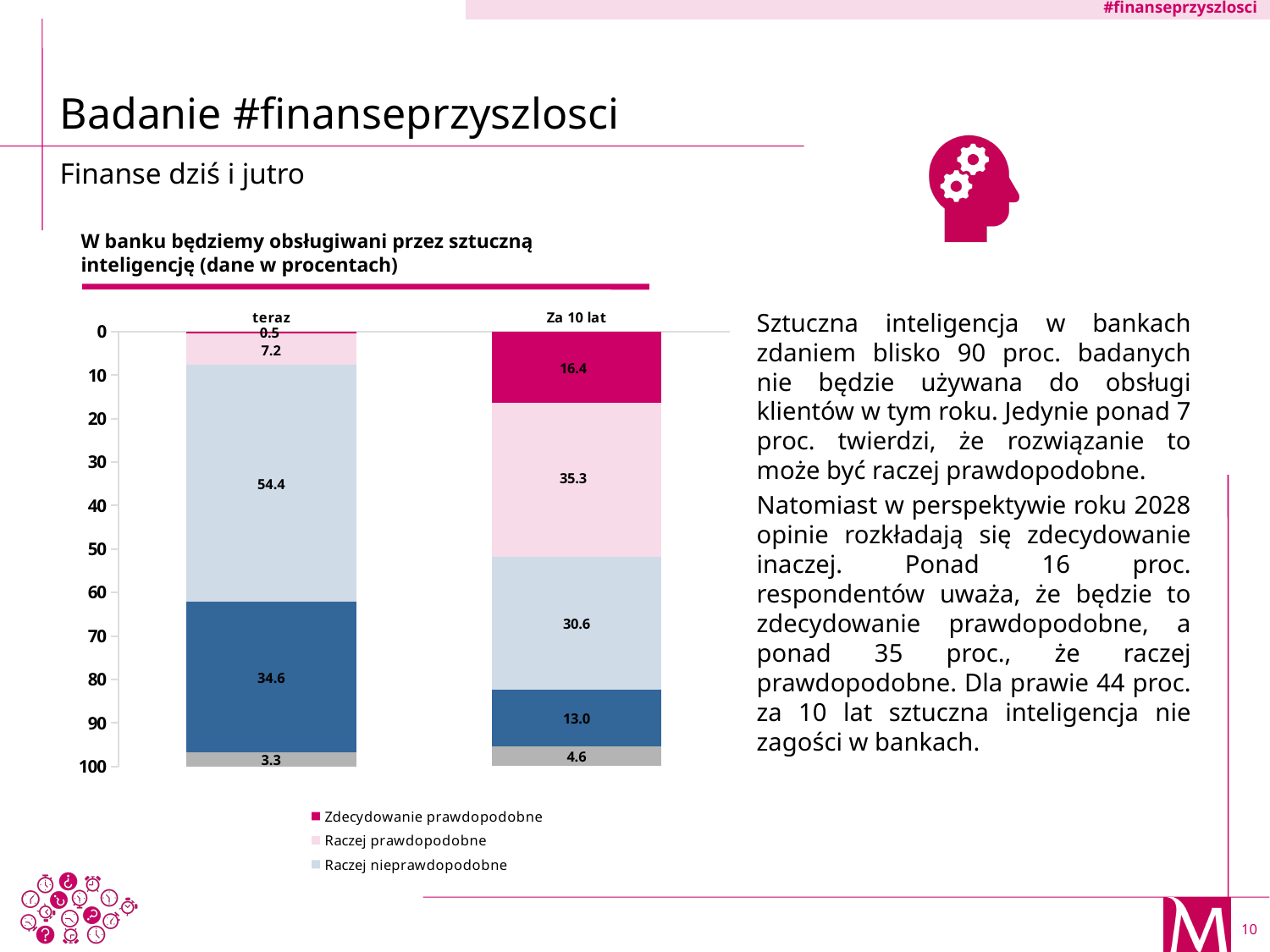
Which legend series has the largest segment in the "Za 10 lat" bar? Raczej prawdopodobne What is the value for "Zdecydowanie prawdopodobne" in the "teraz" bar? 0.5 Which bar has the larger "Raczej prawdopodobne" value, "teraz" or "Za 10 lat"? Za 10 lat What is the value for "Raczej nieprawdopodobne" in the "teraz" bar? 54.4 How many bars (categories) are shown in the chart? 2 What is the value for "Raczej prawdopodobne" in the "teraz" bar? 7.2 What is the difference between the "Raczej nieprawdopodobne" values for "teraz" and "Za 10 lat"? 23.8 What is the value for "Zdecydowanie prawdopodobne" in the "Za 10 lat" bar? 16.4 What is the difference between the "Zdecydowanie prawdopodobne" values for "Za 10 lat" and "teraz"? 15.9 How many series does the legend list? 3 What is the value for "Raczej prawdopodobne" in the "Za 10 lat" bar? 35.3 What kind of chart is shown on the slide? Stacked bar chart